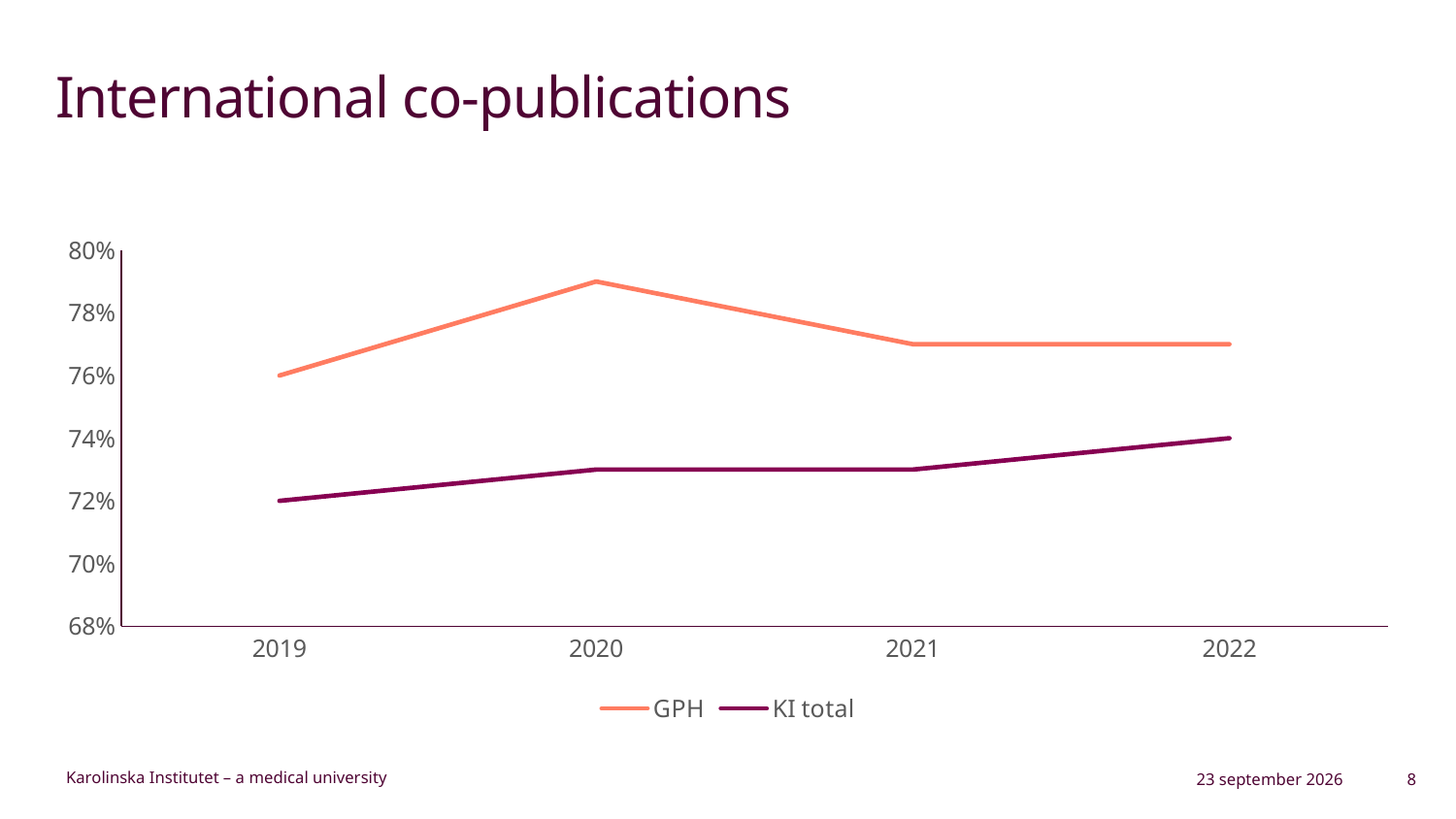
In which year is the KI total value lowest? 2019 Does the KI total line rise or fall from 2019 to 2022? rises What is the value for KI total in 2022? 74% In which year is the GPH value highest? 2020 Which series has the larger value in 2021, GPH or KI total? GPH Is the value for KI total in 2021 greater or less than 74%? less Is the value for GPH in 2020 greater or less than 78%? greater What kind of chart is shown on the slide? line chart How many years are plotted along the x axis? 4 What is the value for GPH in 2019? 76% What is the value for KI total in 2019? 72% How many series does the legend list? 2